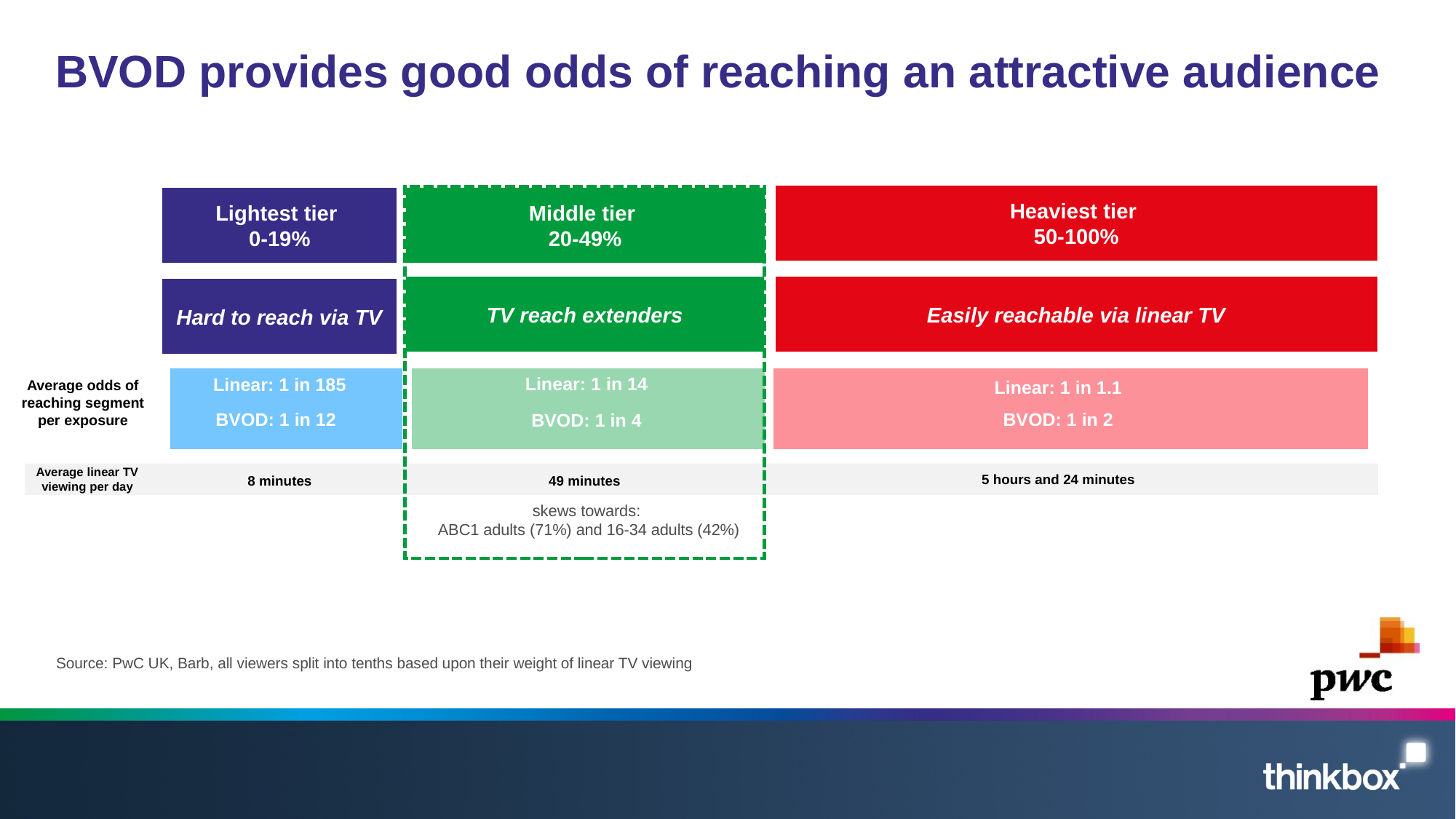
What label describes the Middle tier segment? TV reach extenders What is the average odds of reaching the Lightest tier segment per exposure via BVOD? 1 in 12 What is the average linear TV viewing per day for the Heaviest tier? 5 hours and 24 minutes What is the average linear TV viewing per day for the Middle tier? 49 minutes What is the average odds of reaching the Heaviest tier segment per exposure via BVOD? 1 in 2 How many tiers are shown in the diagram? 3 What is the average odds of reaching the Middle tier segment per exposure via BVOD? 1 in 4 Which tier has the highest average linear TV viewing per day? Heaviest tier What is the average odds of reaching the Middle tier segment per exposure via Linear TV? 1 in 14 What is the average odds of reaching the Lightest tier segment per exposure via Linear TV? 1 in 185 What is the average linear TV viewing per day for the Lightest tier? 8 minutes What percentage range of linear TV viewing defines the Middle tier? 20-49%